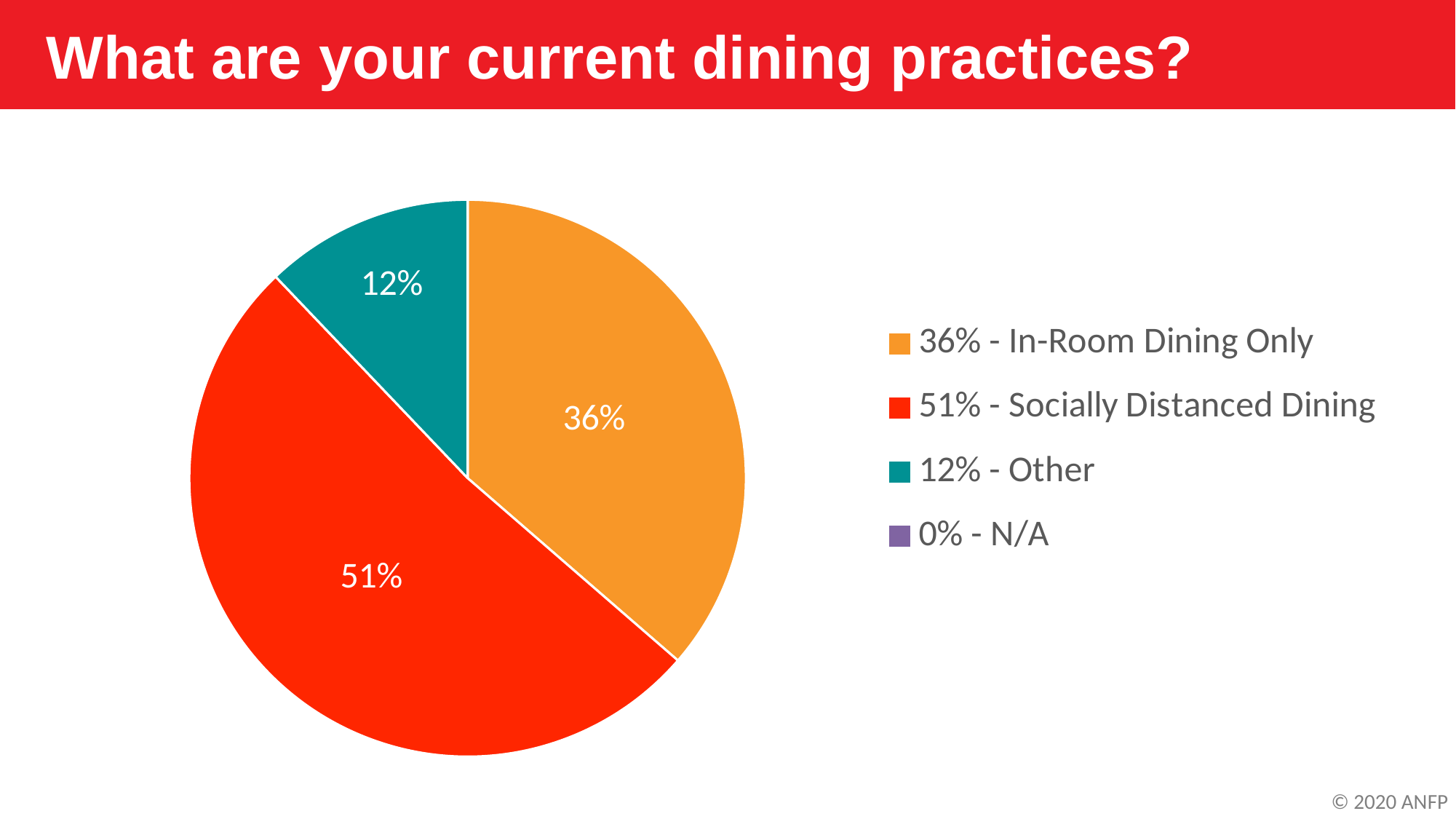
Which category has the largest slice of the pie? Socially Distanced Dining What colour is the Other slice of the pie? teal What is the difference in percentage points between Socially Distanced Dining and In-Room Dining Only? 15 What percentage is shown for N/A in the legend? 0% Which category has the smallest share according to the legend? N/A What share of the pie is In-Room Dining Only? 36% What kind of chart is shown on the slide? pie chart What share of the pie is Other? 12% What share of the pie is Socially Distanced Dining? 51% Which is larger, In-Room Dining Only or Other? In-Room Dining Only What is the difference in percentage points between In-Room Dining Only and Other? 24 How many categories does the legend list? 4